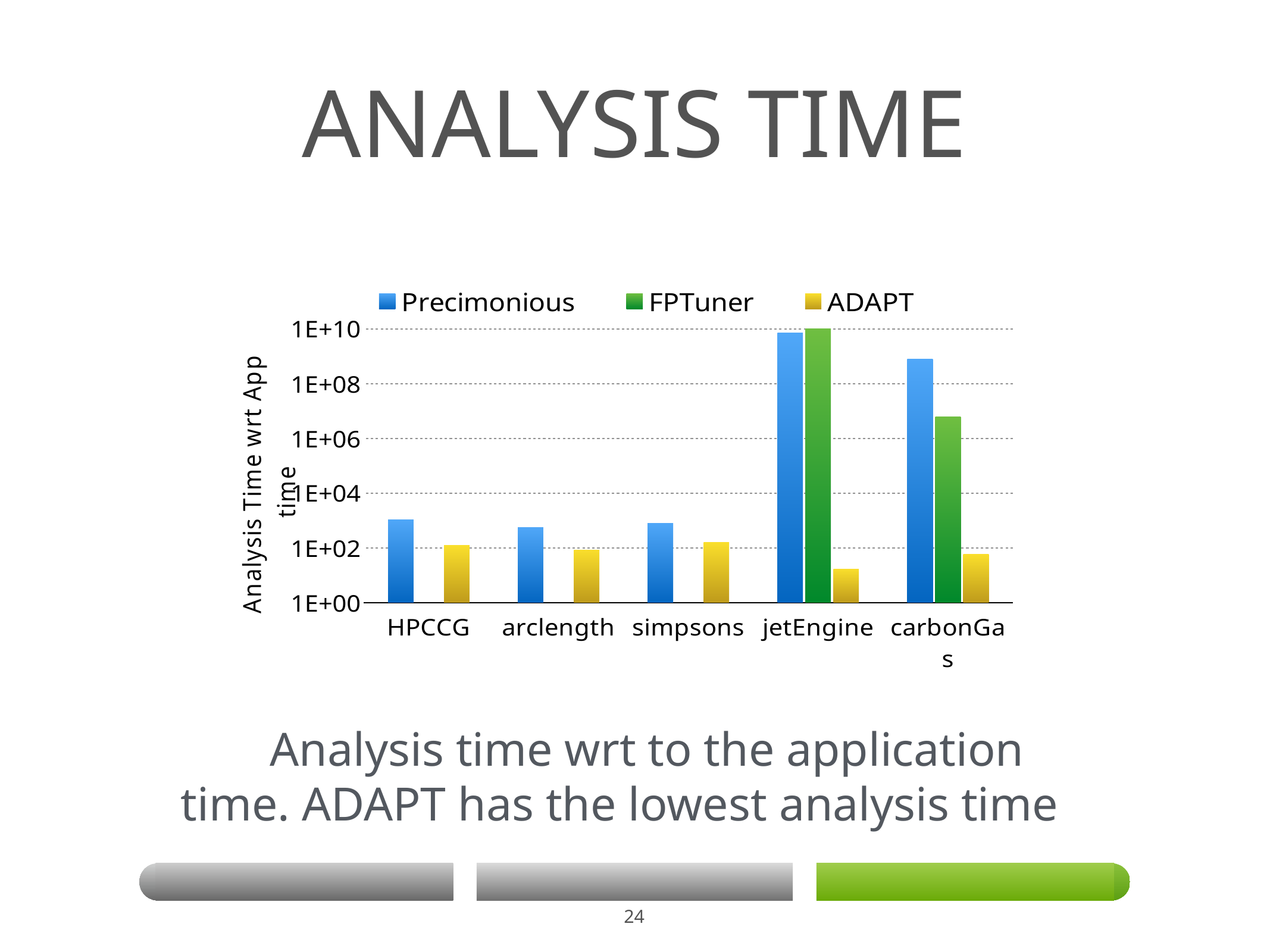
For HPCCG, which is larger: the Precimonious value or the ADAPT value? Precimonious What is the label on the y axis? Analysis Time wrt App time Is the FPTuner value for carbonGas greater or less than 1E+06? greater What kind of chart is shown on the slide? bar chart How many benchmark categories are shown on the x axis? 5 Which category has the lowest ADAPT value? jetEngine How many series does the legend list? 3 Is the Precimonious value for jetEngine greater or less than 1E+08? greater For carbonGas, which series has the highest value? Precimonious Which category has the highest Precimonious value? jetEngine Is the ADAPT value for jetEngine greater or less than 1E+02? less For jetEngine, which series has the lowest value? ADAPT